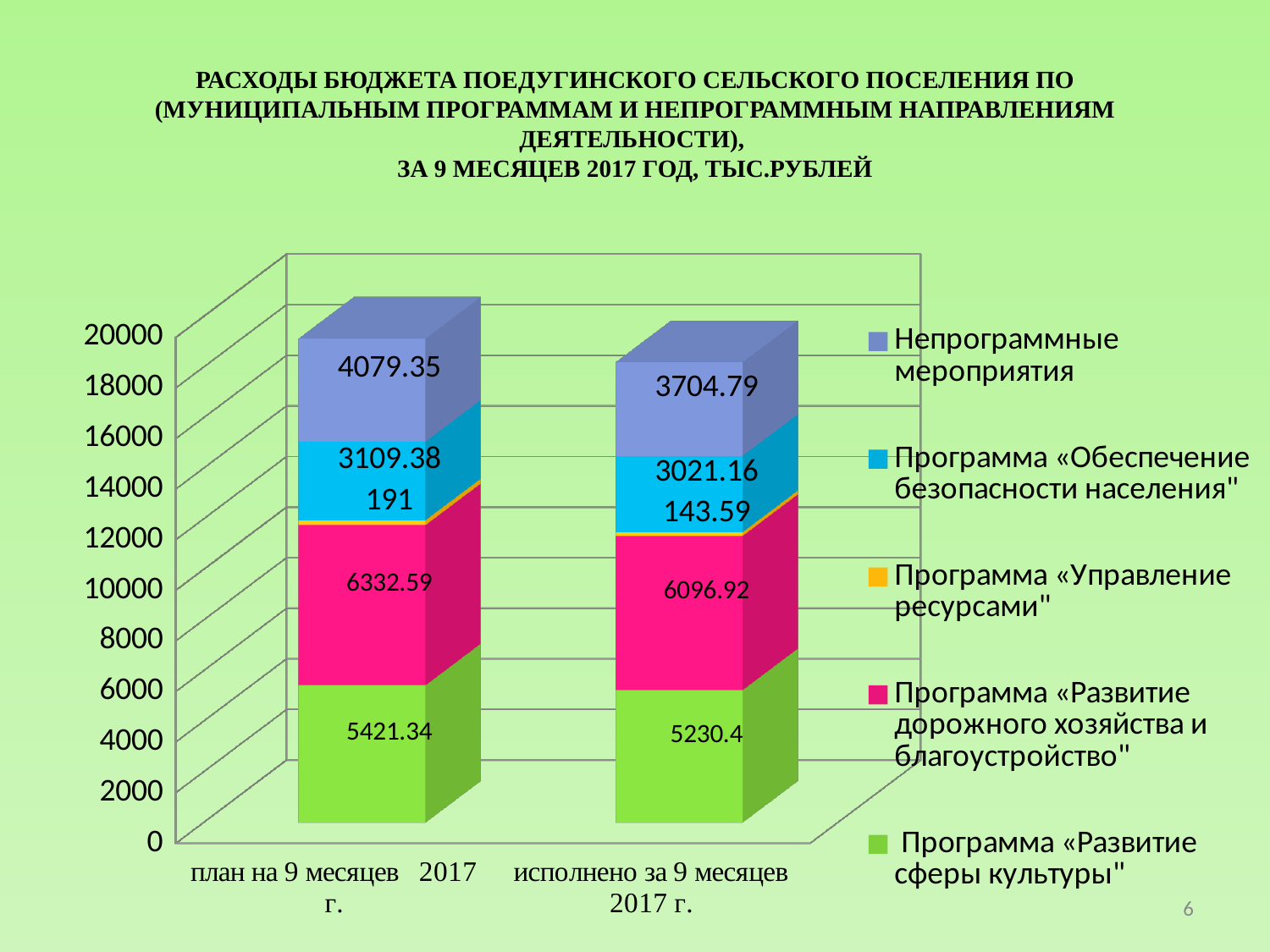
Which is larger: the value for Программа «Обеспечение безопасности населения» in the plan bar or in the executed bar? план на 9 месяцев 2017 г. What is the difference between the planned and executed values for «Непрограммные мероприятия»? 374.56 What is the value for Программа «Развитие дорожного хозяйства и благоустройство» in the «исполнено за 9 месяцев 2017 г.» bar? 6096.92 What is the total of the «исполнено за 9 месяцев 2017 г.» stacked bar? 18196.86 How many categories are shown on the x axis? 2 What kind of chart is shown on the slide? stacked bar chart Which series has the smallest value in the «исполнено за 9 месяцев 2017 г.» bar? Программа «Управление ресурсами» What is the value for Программа «Управление ресурсами» in the «план на 9 месяцев 2017 г.» bar? 191 What is the value for Программа «Развитие сферы культуры» in the «исполнено за 9 месяцев 2017 г.» bar? 5230.4 How many series does the legend list? 5 Which series has the largest value in the «план на 9 месяцев 2017 г.» bar? Программа «Развитие дорожного хозяйства и благоустройство» What is the value for «Непрограммные мероприятия» in the «план на 9 месяцев 2017 г.» bar? 4079.35